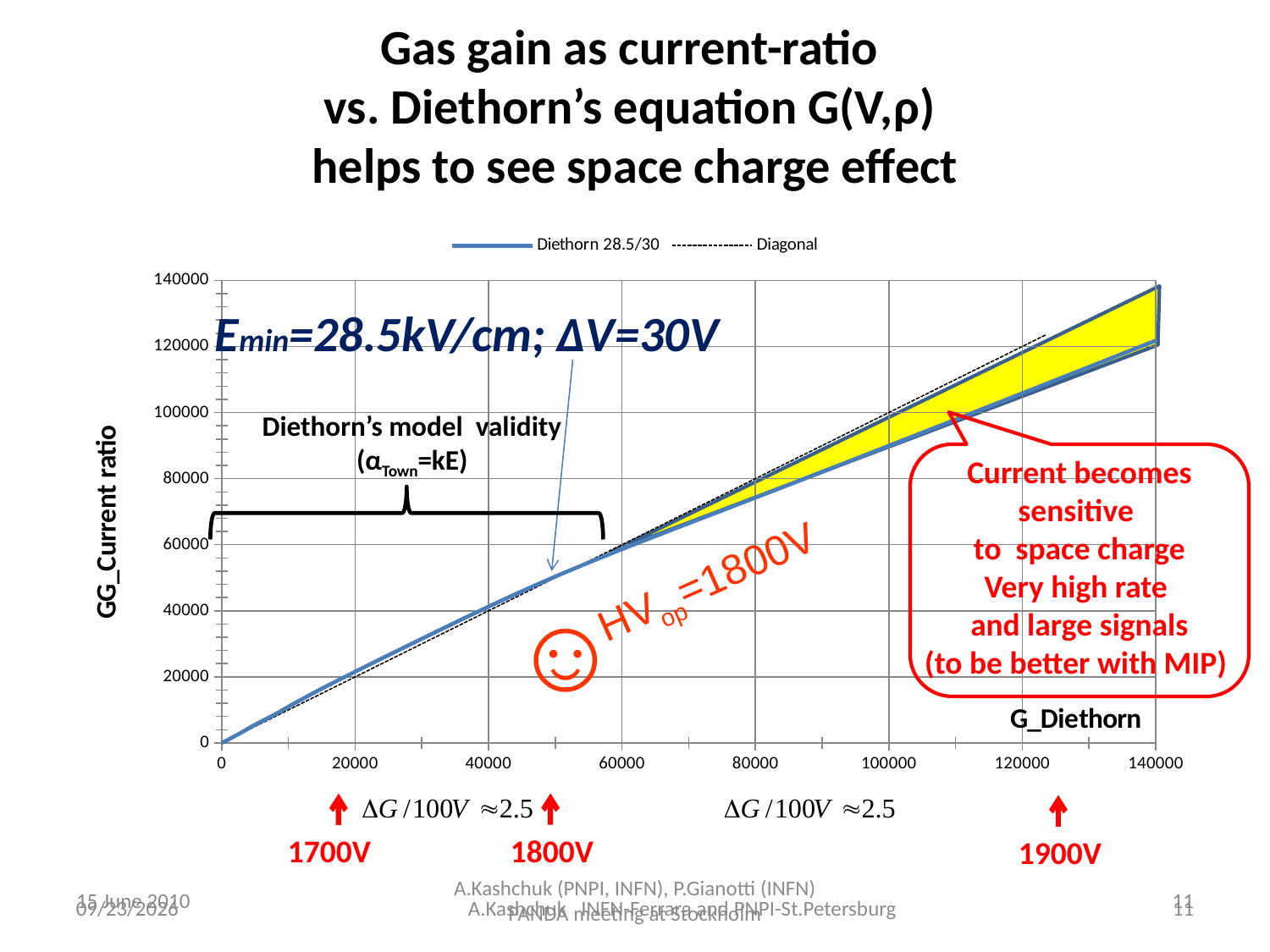
Is the GG_Current ratio value of the Diethorn 28.5/30 series at G_Diethorn = 40000 greater or less than 60000? less What is the label of the vertical axis of the chart? GG_Current ratio Is the GG_Current ratio value of the Diethorn 28.5/30 series at G_Diethorn = 20000 greater or less than 40000? less Is the GG_Current ratio value of the Diethorn 28.5/30 series at G_Diethorn = 40000 greater or less than 20000? greater How many series does the chart legend list? 2 What is the maximum value shown on the vertical axis of the chart? 140000 Does the Diethorn 28.5/30 series rise or fall as G_Diethorn increases along the x axis? rises What are the two series named in the chart legend? Diethorn 28.5/30 and Diagonal What kind of chart is shown on the slide? line chart